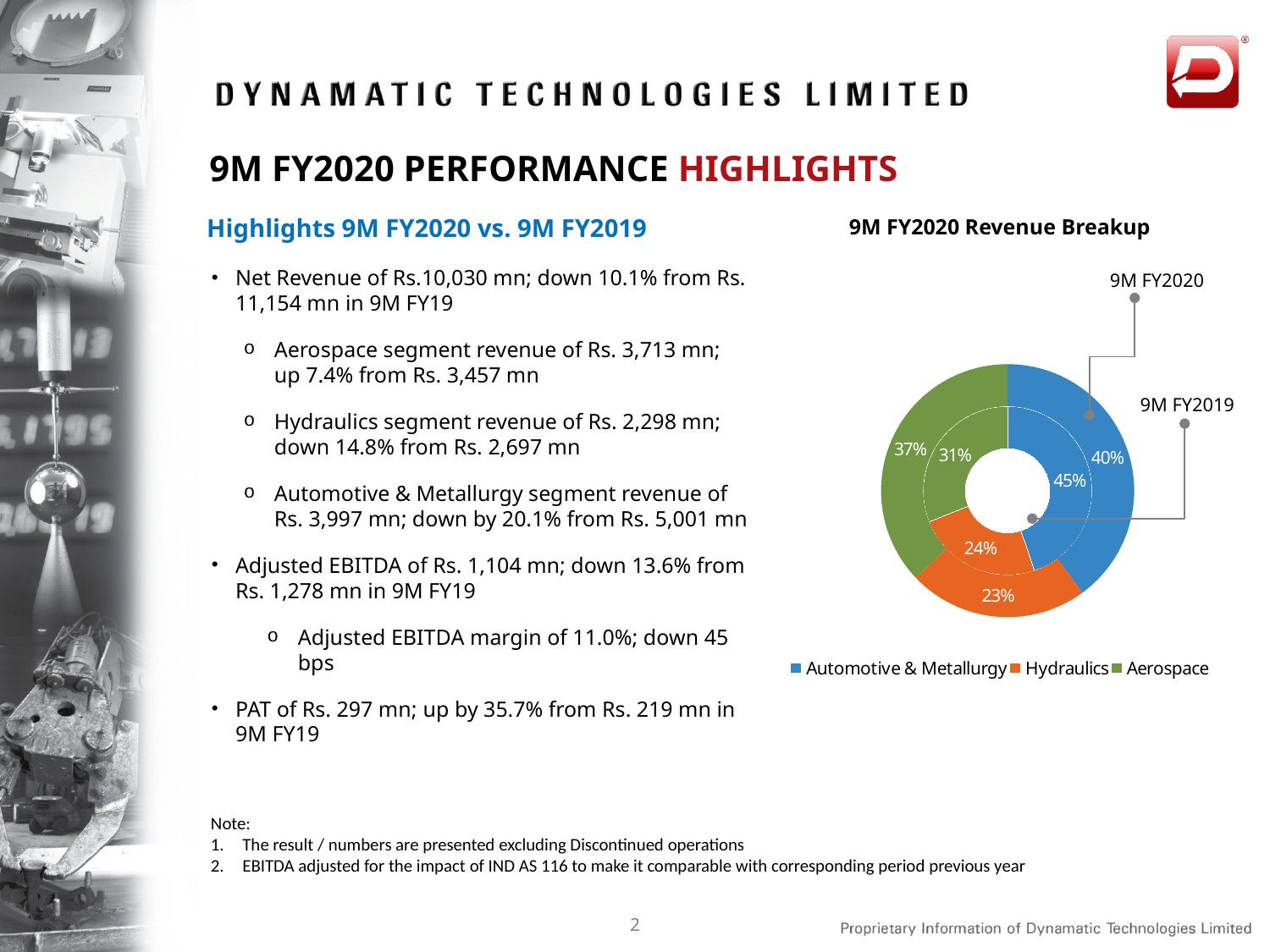
Which colour represents Hydraulics in the revenue breakup chart? Orange What share of revenue does Aerospace account for in the 9M FY2020 ring? 37% Which is larger: the Hydraulics share in 9M FY2020 or the Aerospace share in 9M FY2020? Aerospace What share of revenue does Automotive & Metallurgy account for in the 9M FY2019 ring? 45% What kind of chart is shown under the title '9M FY2020 Revenue Breakup'? Doughnut chart What share of revenue does Aerospace account for in the 9M FY2019 ring? 31% Which segment has the smallest share in the 9M FY2019 ring? Hydraulics What share of revenue does Automotive & Metallurgy account for in the 9M FY2020 ring? 40% By how many percentage points did the Aerospace share change from 9M FY2019 to 9M FY2020? 6 percentage points Which segment has the largest share in the 9M FY2020 ring? Automotive & Metallurgy How many segments does the legend of the revenue breakup chart list? 3 What share of revenue does Hydraulics account for in the 9M FY2020 ring? 23%